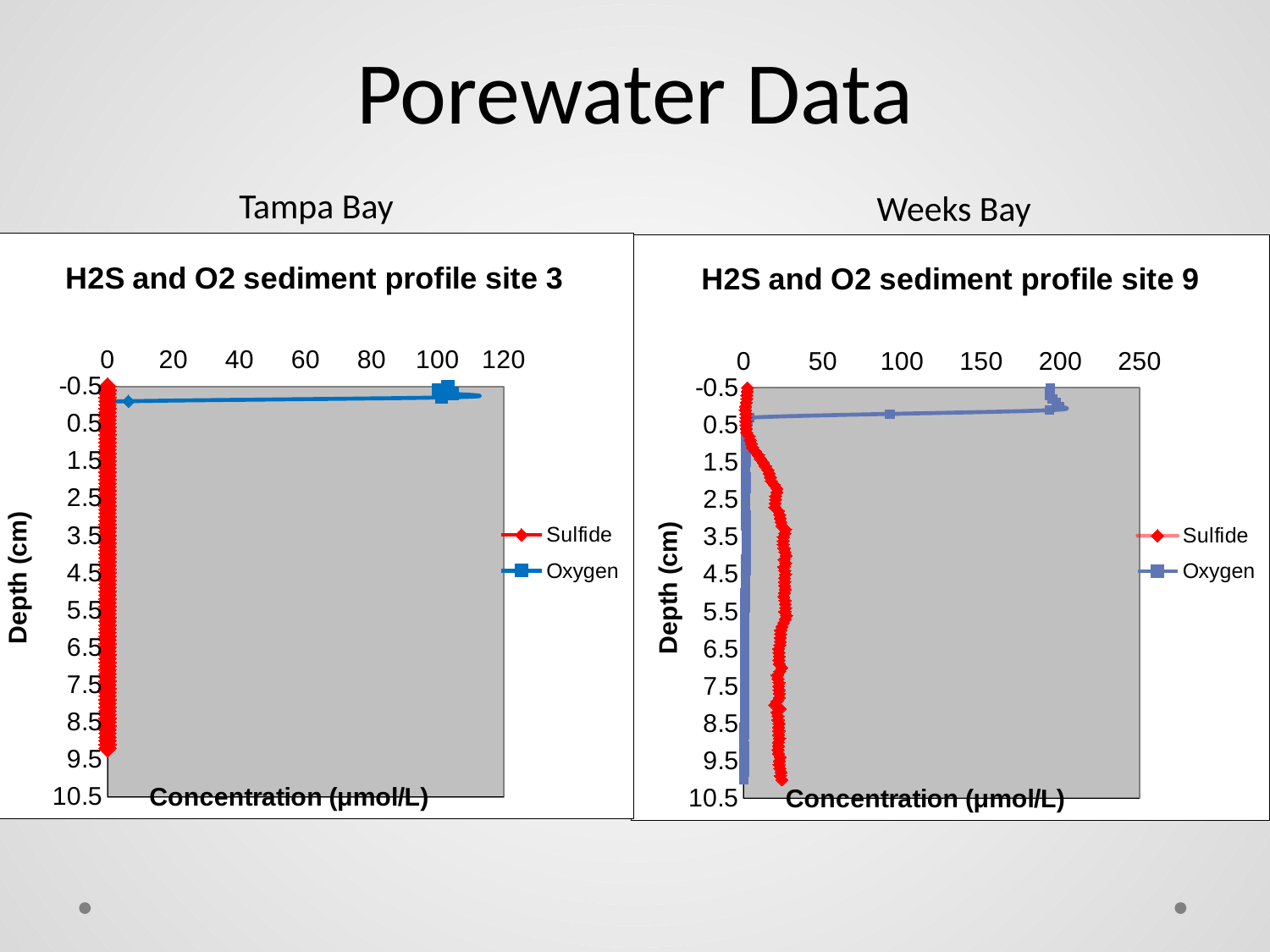
On the 'H2S and O2 sediment profile site 9' chart, does the Sulfide concentration generally rise or fall as depth increases from 0.5 cm to 3.5 cm? rise On the 'H2S and O2 sediment profile site 9' chart, is the Oxygen concentration at the shallowest depth (-0.5 cm) greater or less than 150? greater On the 'H2S and O2 sediment profile site 9' chart, which series has the higher concentration at 5.5 cm depth, Sulfide or Oxygen? Sulfide On the 'H2S and O2 sediment profile site 9' chart, does the Oxygen concentration rise or fall as depth increases from -0.5 cm to 0.5 cm? fall On the 'H2S and O2 sediment profile site 3' chart, is the Sulfide concentration at 4.5 cm depth greater or less than 20? less What is the label on the horizontal axis of the 'H2S and O2 sediment profile site 9' chart? Concentration (µmol/L) On the 'H2S and O2 sediment profile site 3' chart, which series has the higher concentration at -0.5 cm depth, Sulfide or Oxygen? Oxygen What kind of chart is the 'H2S and O2 sediment profile site 3' chart? line chart On the 'H2S and O2 sediment profile site 3' chart, is the Oxygen concentration at the shallowest depth (-0.5 cm) greater or less than 80? greater What are the two series named in the legend of the 'H2S and O2 sediment profile site 9' chart? Sulfide and Oxygen How many series does the legend list on the 'H2S and O2 sediment profile site 3' chart? 2